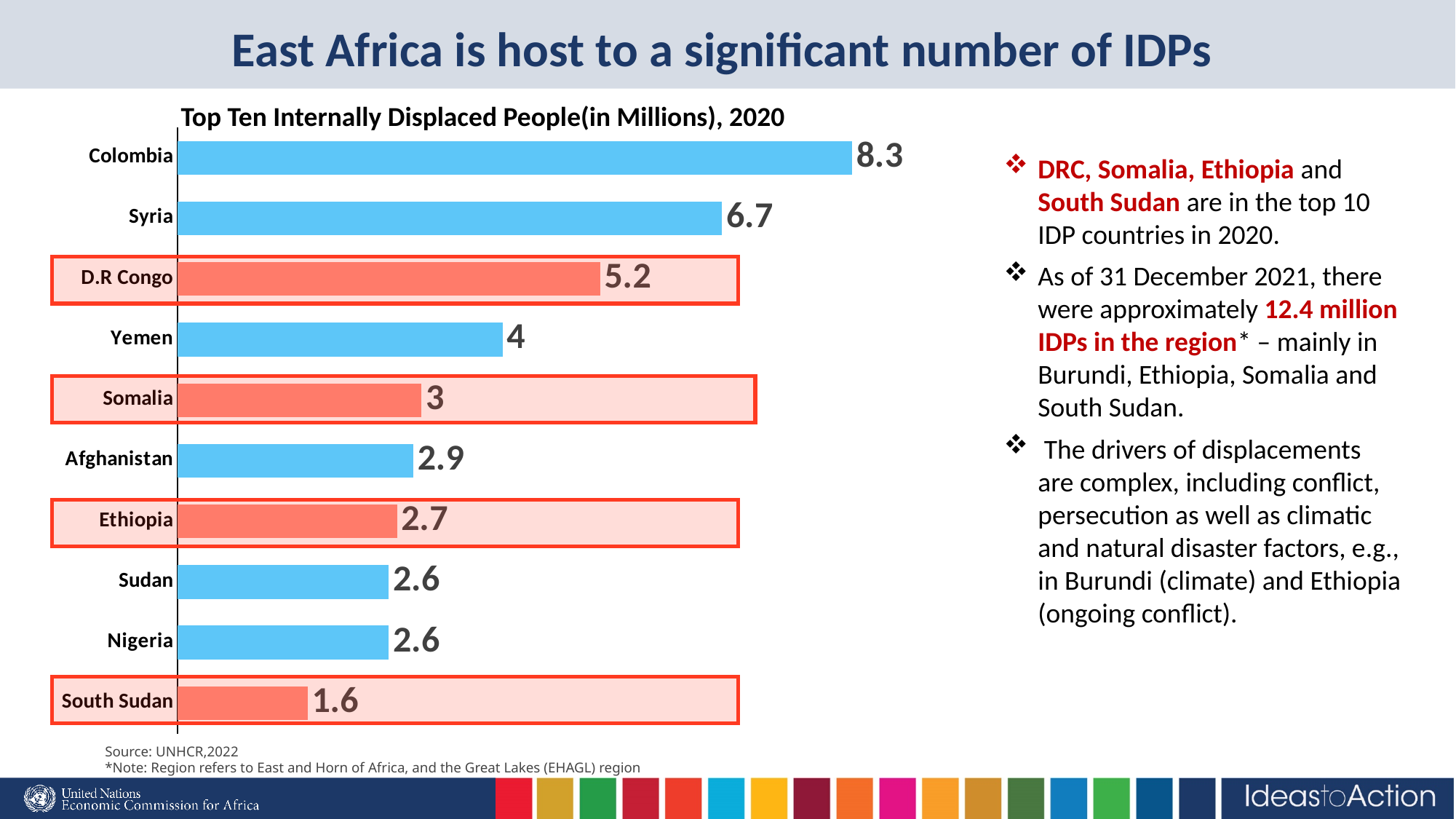
What is the title of the chart? Top Ten Internally Displaced People(in Millions), 2020 Which country has the highest number of internally displaced people? Colombia What is the difference between the values for D.R Congo and Ethiopia? 2.5 What kind of chart is shown on the slide? Bar chart Which country has the lowest number of internally displaced people? South Sudan What is the value for Somalia? 3 What is the difference between the values for Colombia and Syria? 1.6 How many countries are shown in the chart? 10 Which is larger, the value for Yemen or the value for Somalia? Yemen What is the value for South Sudan? 1.6 What is the value for Colombia? 8.3 What is the value for D.R Congo? 5.2